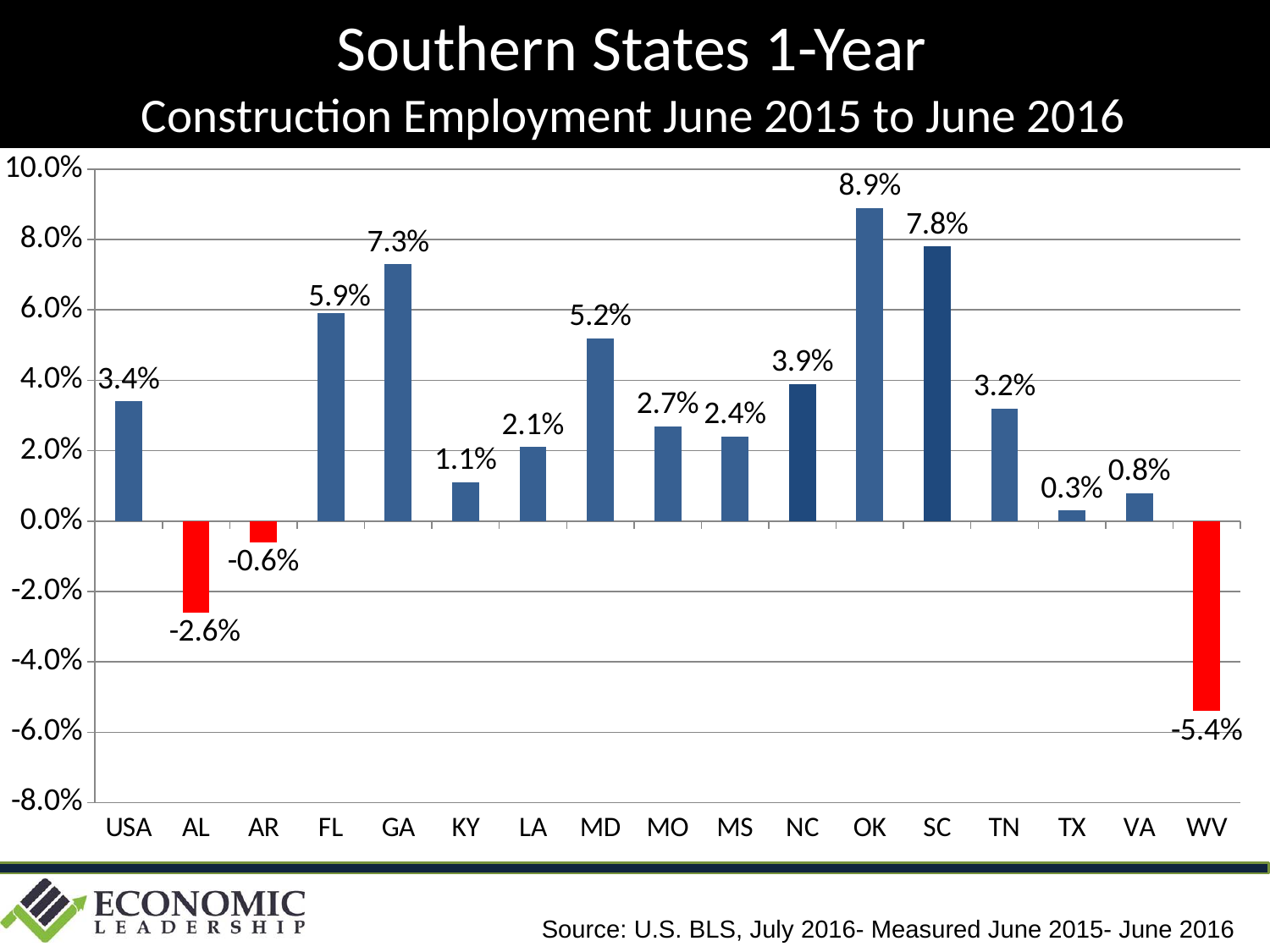
Which is larger, the value for FL or the value for MD? FL What kind of chart is this? Bar chart How many categories are shown on the x axis? 17 Which category has the lowest value? WV What is the value for WV? -5.4% How many categories have negative values? 3 Which category has the highest value? OK What colour are the bars with negative values? Red What is the value for USA? 3.4% What is the difference between the values for OK and SC? 1.1% What is the difference between the values for GA and KY? 6.2% What is the value for NC? 3.9%